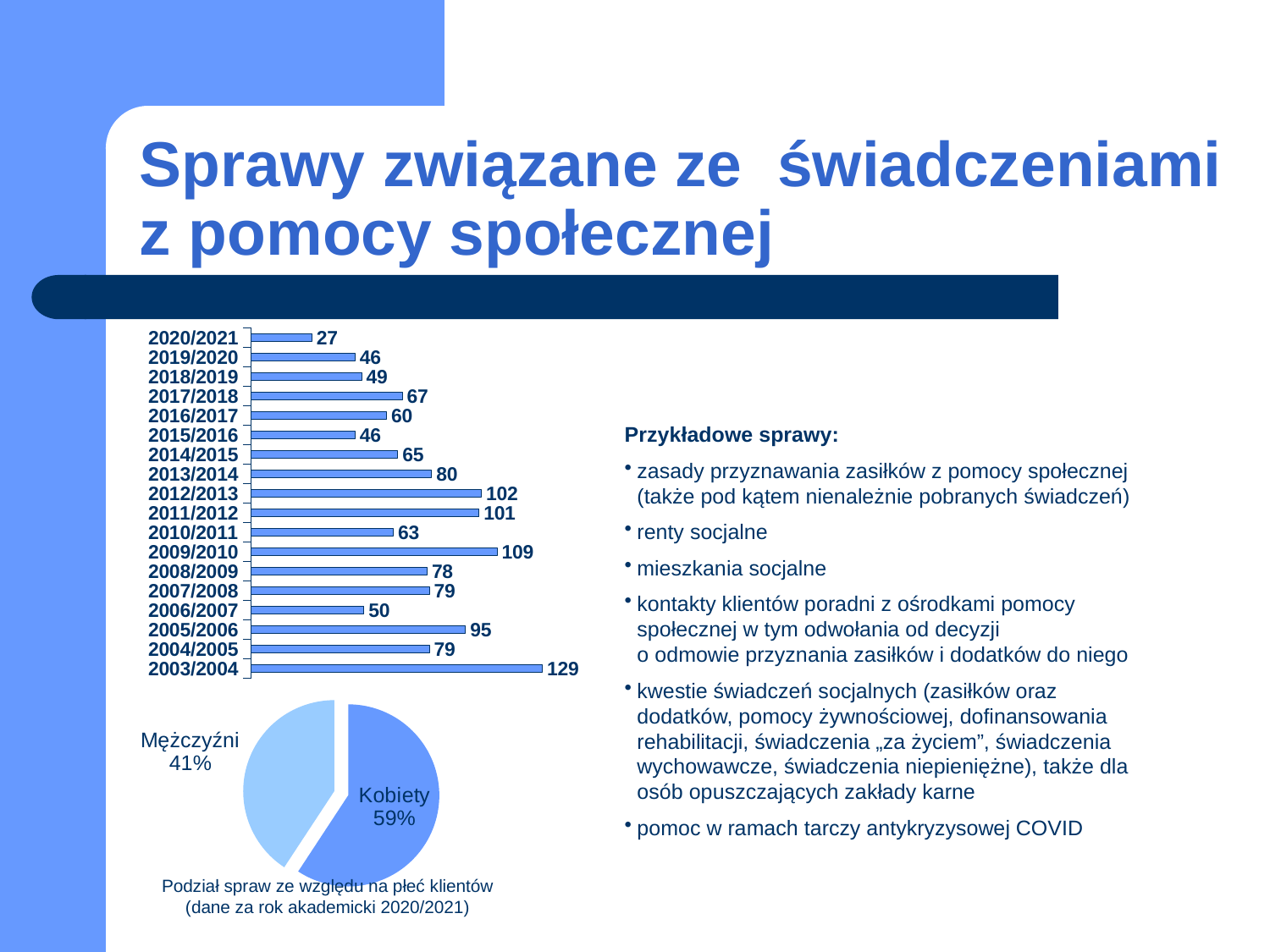
In the pie chart, what share is labelled Kobiety? 59% In the bar chart, which academic year has the highest value? 2003/2004 In the bar chart, which is larger, the value for 2005/2006 or the value for 2006/2007? 2005/2006 How many academic years are shown in the bar chart? 18 What type of chart is the bottom-left chart on the slide? pie chart In the bar chart, what is the value for 2003/2004? 129 In the bar chart, which academic year has the lowest value? 2020/2021 What type of chart is the top-left chart on the slide? bar chart In the bar chart, what is the value for 2009/2010? 109 In the bar chart, what is the value for 2020/2021? 27 In the bar chart, what is the difference between the values for 2012/2013 and 2013/2014? 22 In the pie chart, what share is labelled Mężczyźni? 41%